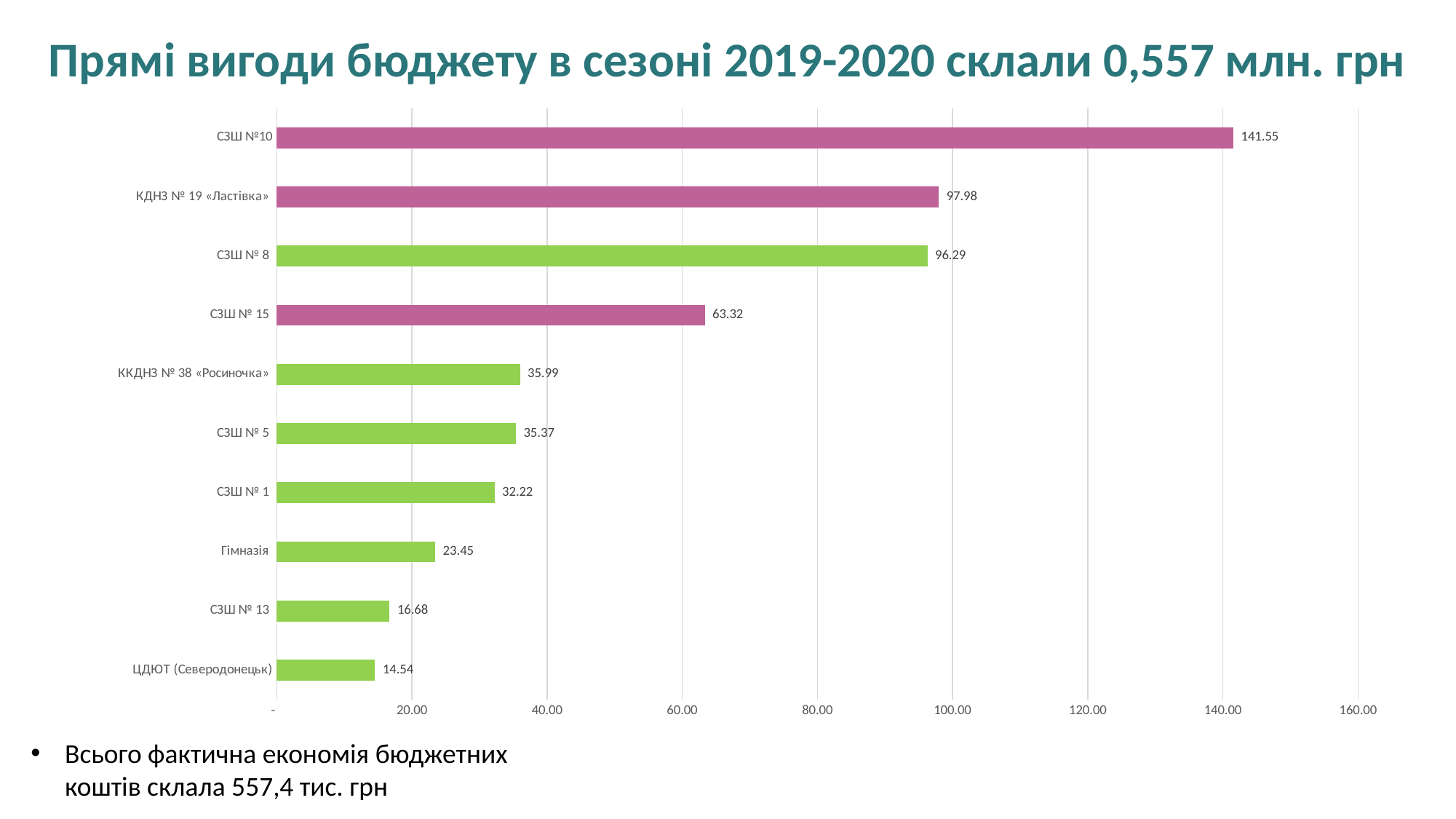
What is the value for КДНЗ № 19 «Ластівка»? 97.98 What kind of chart is shown on the slide? bar chart Which category has the lowest value? ЦДЮТ (Северодонецьк) How many categories are shown in the chart? 10 Which is larger, the value for СЗШ № 15 or the value for СЗШ № 1? СЗШ № 15 What is the difference between the values for СЗШ №10 and КДНЗ № 19 «Ластівка»? 43.57 What is the value for СЗШ №10? 141.55 How many bars in the chart are coloured pink rather than green? 3 What is the value for Гімназія? 23.45 What is the difference between the values for СЗШ № 15 and ККДНЗ № 38 «Росиночка»? 27.33 Which category has the highest value? СЗШ №10 What is the value for ЦДЮТ (Северодонецьк)? 14.54